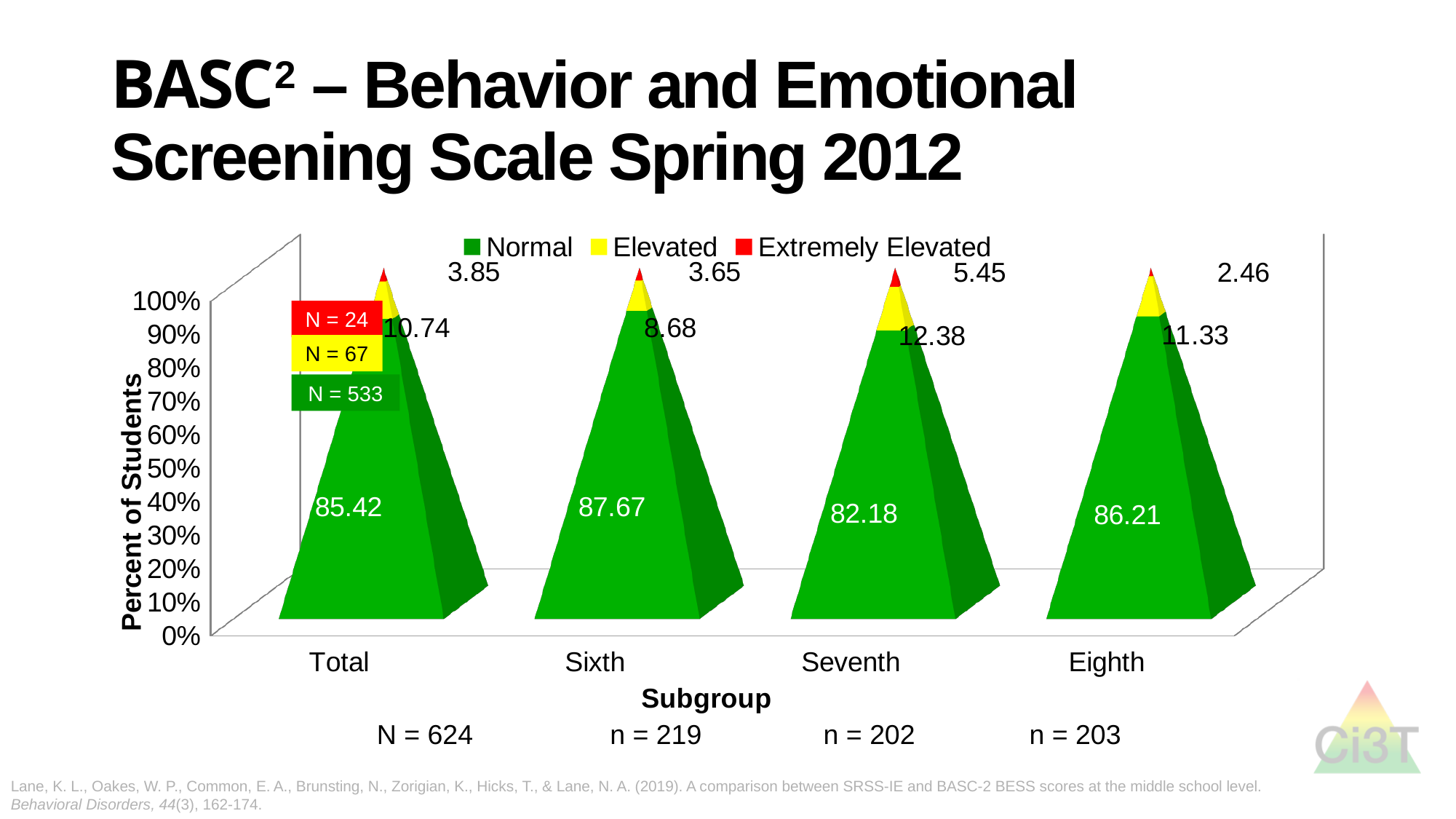
What is the Normal value for the Total subgroup? 85.42 What is the Elevated value for the Seventh subgroup? 12.38 Which subgroup has the lowest Extremely Elevated value? Eighth What is the Normal value for the Sixth subgroup? 87.67 Which subgroup has the highest Elevated value? Seventh How many series does the legend list? 3 What is the Extremely Elevated value for the Eighth subgroup? 2.46 What is the sample size shown for the Seventh subgroup? n = 202 Which subgroup has the highest Normal value? Sixth Which is larger, the Elevated value for Total or for Eighth? Eighth How many subgroups are shown on the x axis? 4 What is the difference between the Normal values for Sixth and Seventh? 5.49